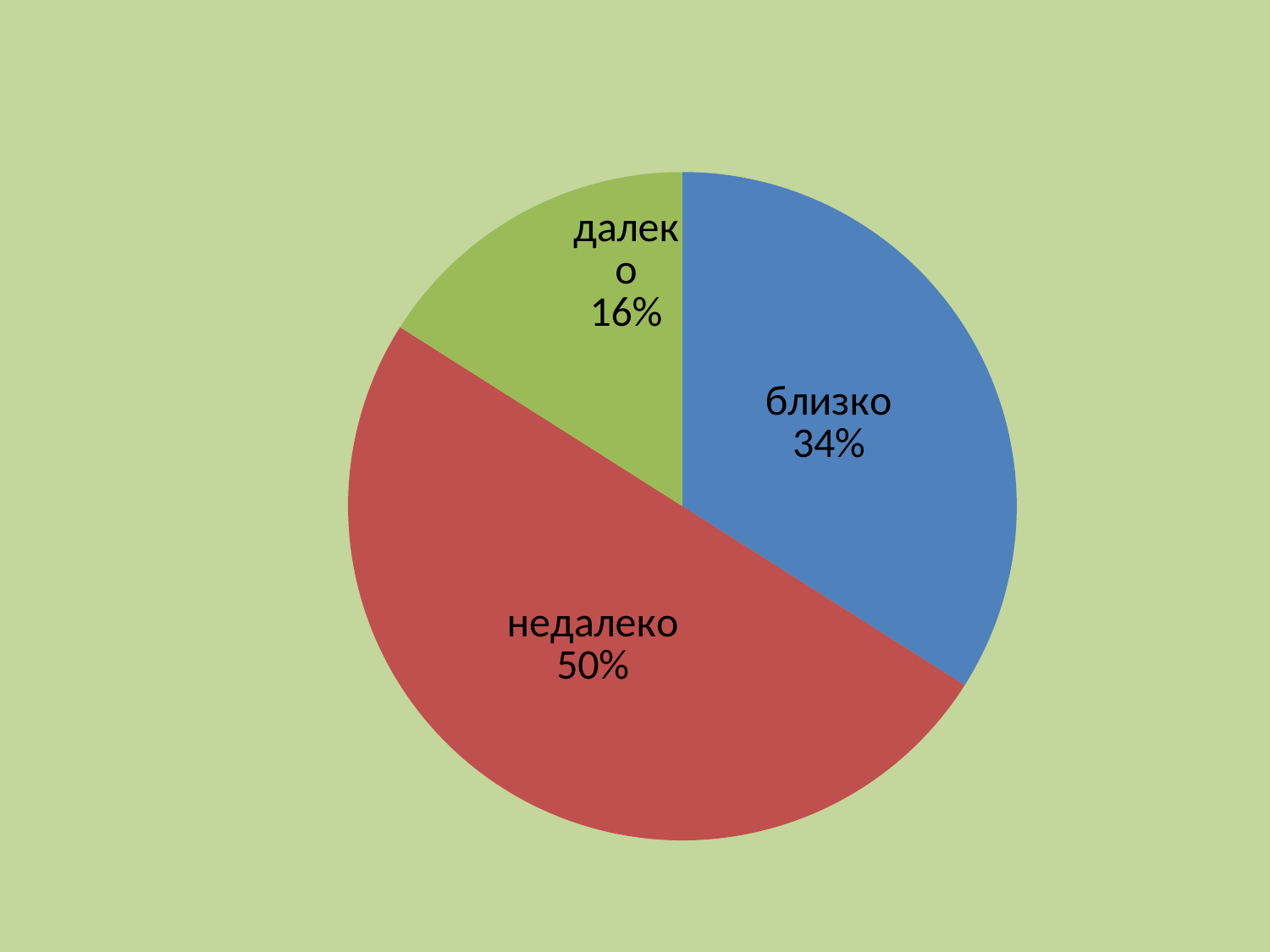
What colour is the slice labelled "недалеко"? red Which slice is larger, "близко" or "далеко"? близко Which slice of the pie is the largest? недалеко What colour is the slice labelled "близко"? blue What is the difference in percentage points between the "недалеко" slice and the "близко" slice? 16 What kind of chart is shown on the slide? pie chart Which slice of the pie is the smallest? далеко What share of the pie does the slice labelled "недалеко" represent? 50% What is the difference in percentage points between the "близко" slice and the "далеко" slice? 18 What share of the pie does the slice labelled "далеко" represent? 16% What share of the pie does the slice labelled "близко" represent? 34% How many slices does the pie chart have? 3